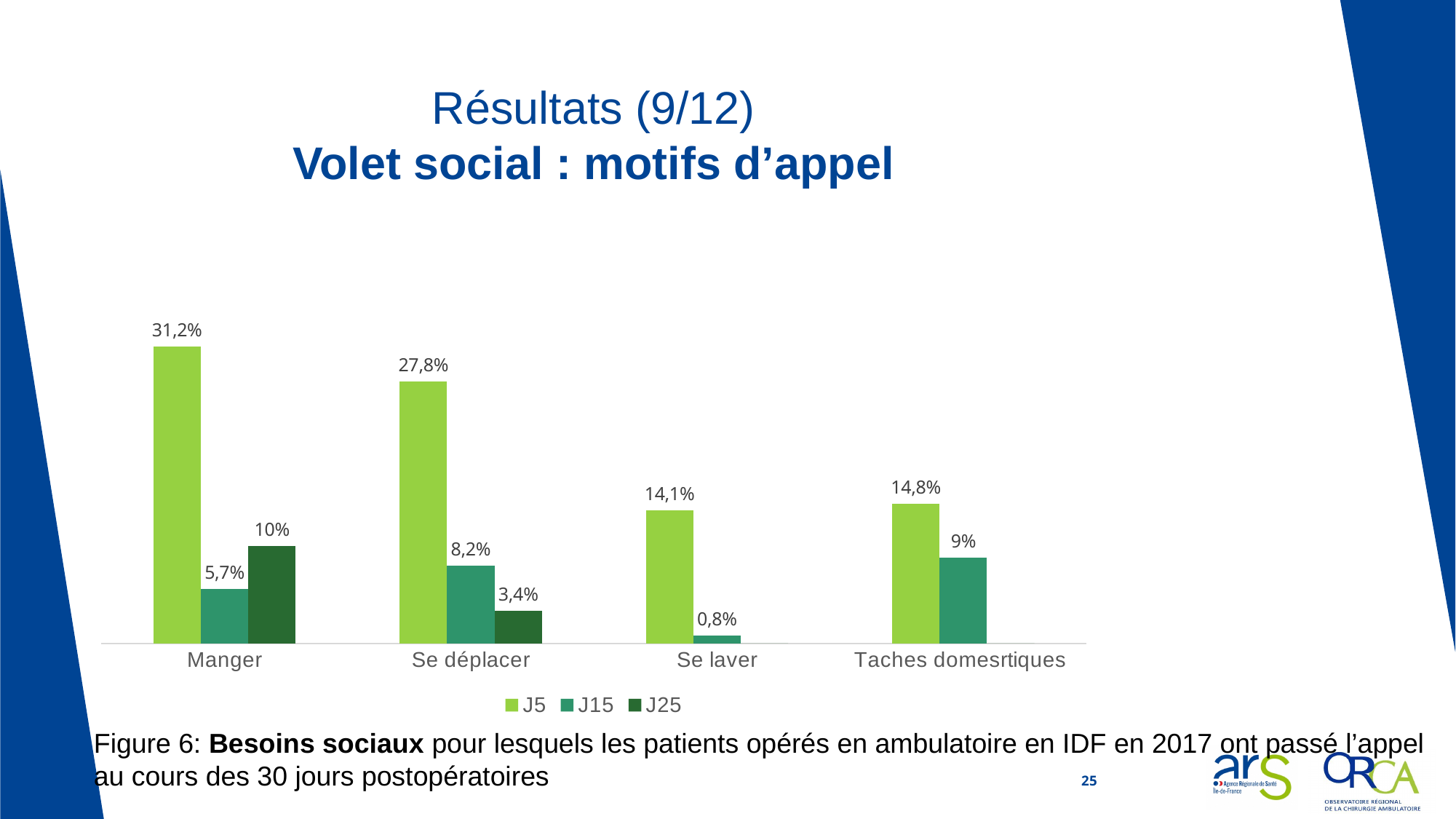
How many categories are shown on the x axis? 4 What is the difference between the J5 values for Manger and Se déplacer? 3,4% Which is larger for Se déplacer, the J15 value or the J25 value? J15 How many series does the legend list? 3 What is the J15 value for Se déplacer? 8,2% What is the J15 value for Se laver? 0,8% Which category has the lowest J15 value? Se laver What is the difference between the J25 and J15 values for Manger? 4,3% What kind of chart is shown on the slide? Bar chart What is the J5 value for Manger? 31,2% What is the J25 value for Manger? 10% Which category has the highest J5 value? Manger